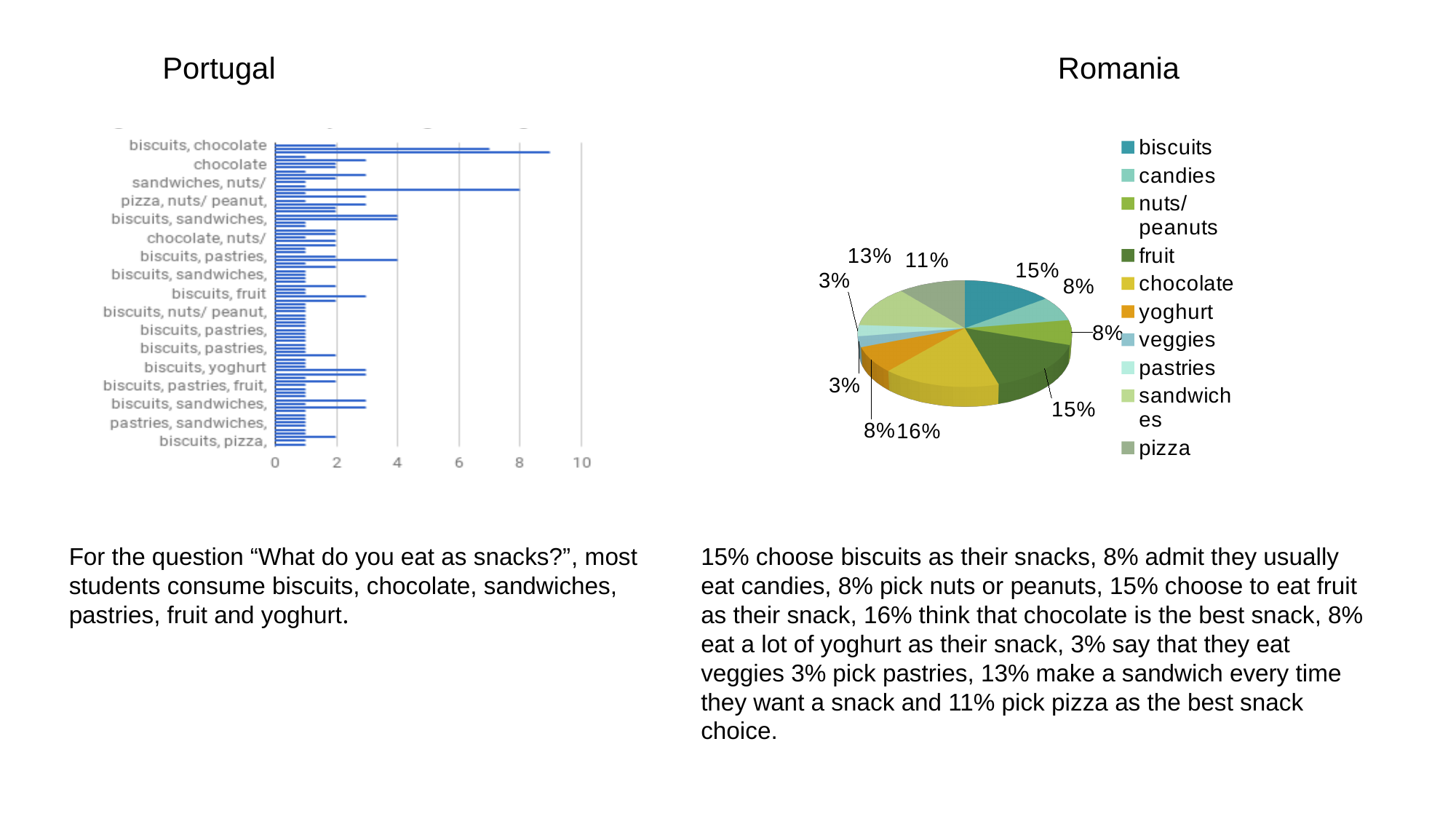
In the Romania chart, which snack has the largest share? chocolate In the Romania chart, which is larger, the share for sandwiches or the share for yoghurt? sandwiches In the Romania chart, what percentage is shown for sandwiches? 13% What is the highest value shown on the x axis of the Portugal chart? 10 In the Romania chart, what is the difference between the shares for chocolate and pizza? 5% What kind of chart is the Portugal chart? bar chart What kind of chart is the Romania chart? pie chart How many entries does the legend of the Romania chart list? 10 In the Romania chart, what percentage is shown for chocolate? 16% In the Romania chart, what percentage is shown for pizza? 11% In the Romania chart, what is the combined share of biscuits and fruit? 30%